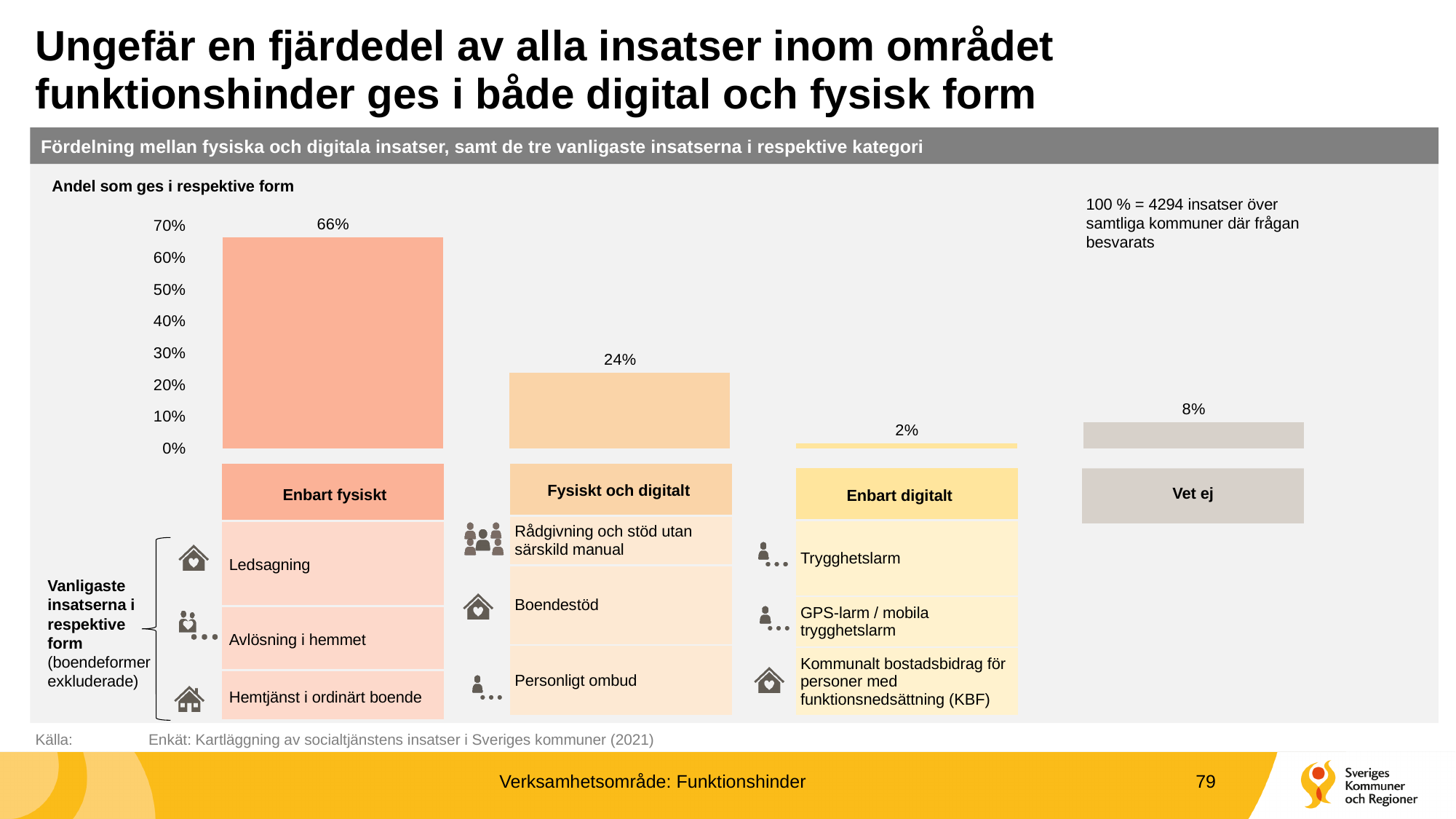
Which category has the lowest share? Enbart digitalt According to the note on the chart, how many insatser does 100 % correspond to? 4294 insatser What is the difference in percentage points between 'Enbart fysiskt' and 'Fysiskt och digitalt'? 42 percentage points What is the value shown for 'Vet ej'? 8% What kind of chart is used to show the share given in each form? Bar chart Which is larger, the share for 'Vet ej' or the share for 'Enbart digitalt'? Vet ej What share of insatser is given 'Fysiskt och digitalt'? 24% What share of insatser is given 'Enbart fysiskt'? 66% Is the value for 'Fysiskt och digitalt' greater or less than 30%? less What share of insatser is given 'Enbart digitalt'? 2% How many categories are shown in the bar chart? 4 Which category has the highest share? Enbart fysiskt